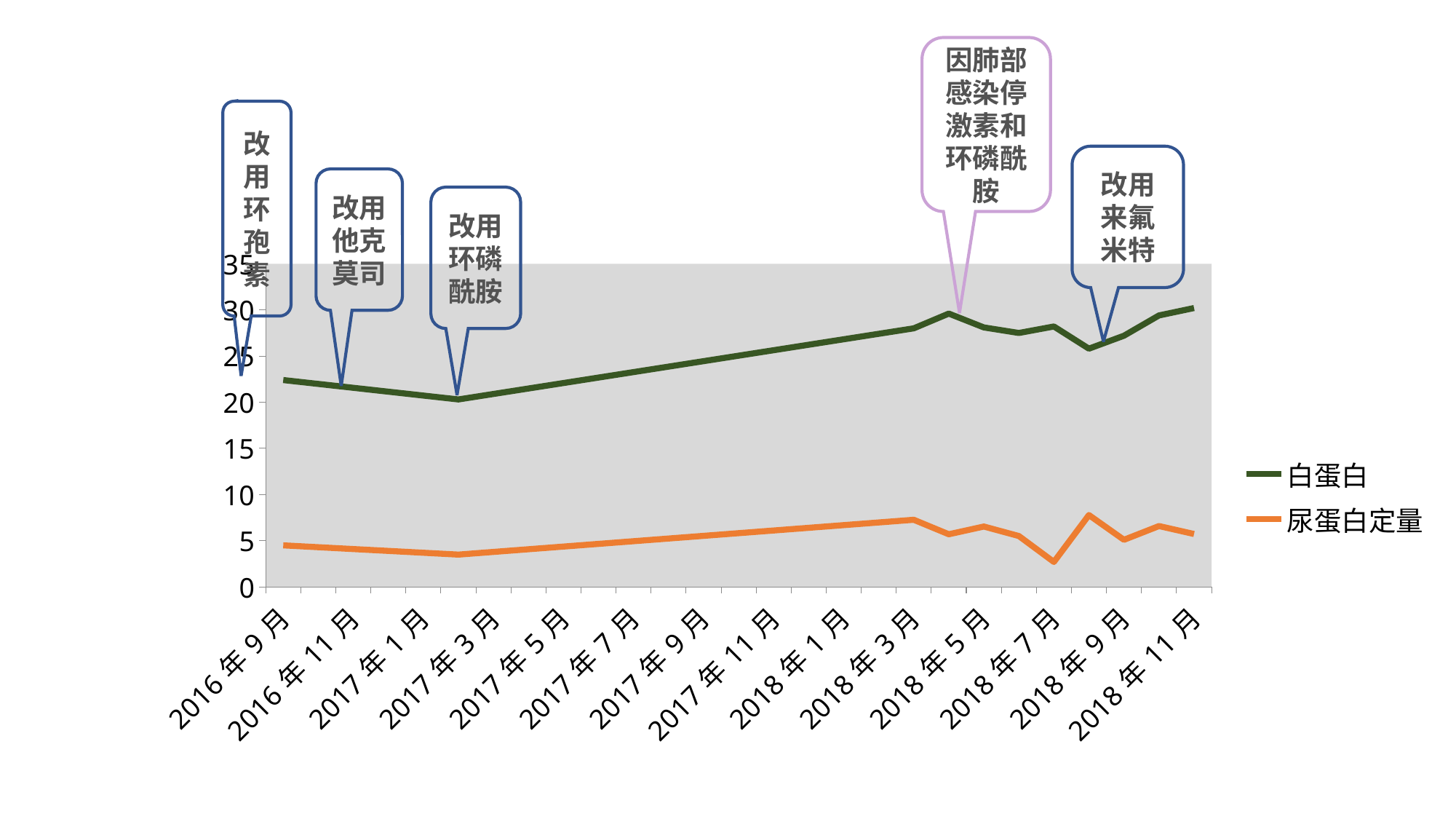
How many series does the legend list? 2 What kind of chart is shown on the slide? line chart At which time point is 尿蛋白定量 lowest? 2018年7月 Which series is shown in orange in the legend? 尿蛋白定量 Is the value of 尿蛋白定量 at 2018年7月 greater or less than 5? less Does the 白蛋白 line rise or fall from 2017年3月 to 2018年3月? rise Is the value of 白蛋白 at 2017年3月 greater or less than 25? less Is the value of 白蛋白 at 2016年9月 greater or less than 20? greater How many time points are labelled on the x axis? 14 At 2018年1月, which series has the larger value, 白蛋白 or 尿蛋白定量? 白蛋白 Which series is shown in green in the legend? 白蛋白